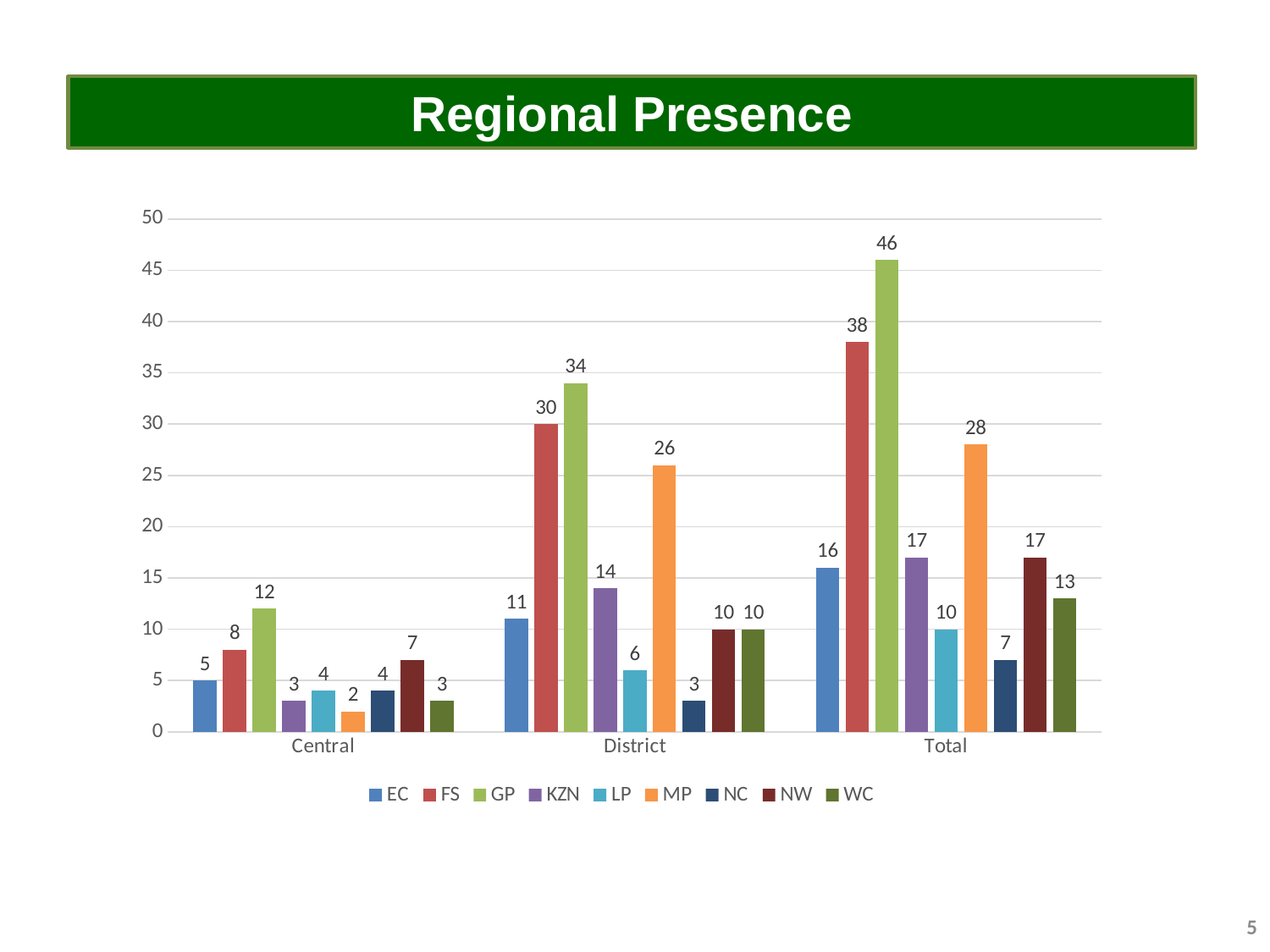
Which series has the highest value in the District category? GP In the District category, which is larger, the value for KZN or the value for LP? KZN What is the difference between the FS and EC values in the Total category? 22 What is the value for NW in the Central category? 7 Which series has the lowest value in the Central category? MP How many series does the legend list? 9 What is the value for MP in the District category? 26 How many categories are shown on the x axis? 3 What is the value for GP in the Total category? 46 What kind of chart is shown on the slide? Bar chart Is the value for FS in the District category greater or less than 25? greater What is the title of the slide containing the chart? Regional Presence